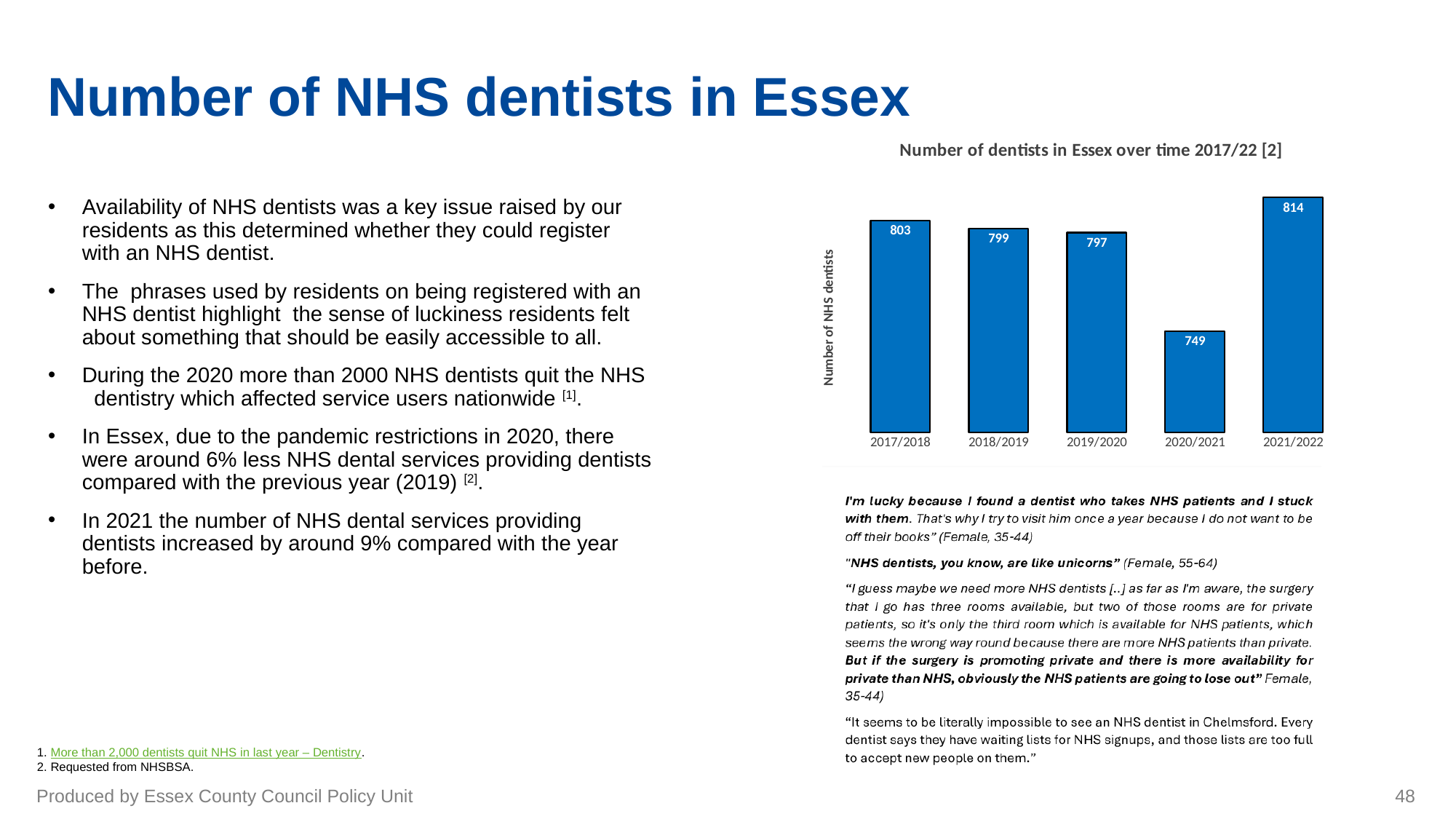
What is the difference between the number of dentists in 2021/2022 and 2020/2021? 65 Which year has the highest number of NHS dentists in Essex? 2021/2022 Which year has more NHS dentists, 2018/2019 or 2020/2021? 2018/2019 What is the title of the chart? Number of dentists in Essex over time 2017/22 [2] What is the number of NHS dentists in Essex for 2021/2022? 814 Does the number of NHS dentists rise or fall from 2017/2018 to 2019/2020? Fall How many years are shown on the chart? 5 Which year has the lowest number of NHS dentists in Essex? 2020/2021 What is the number of NHS dentists in Essex for 2017/2018? 803 What is the difference between the number of dentists in 2017/2018 and 2019/2020? 6 What kind of chart is used to show the number of dentists in Essex over time? Bar chart What is the number of NHS dentists in Essex for 2020/2021? 749